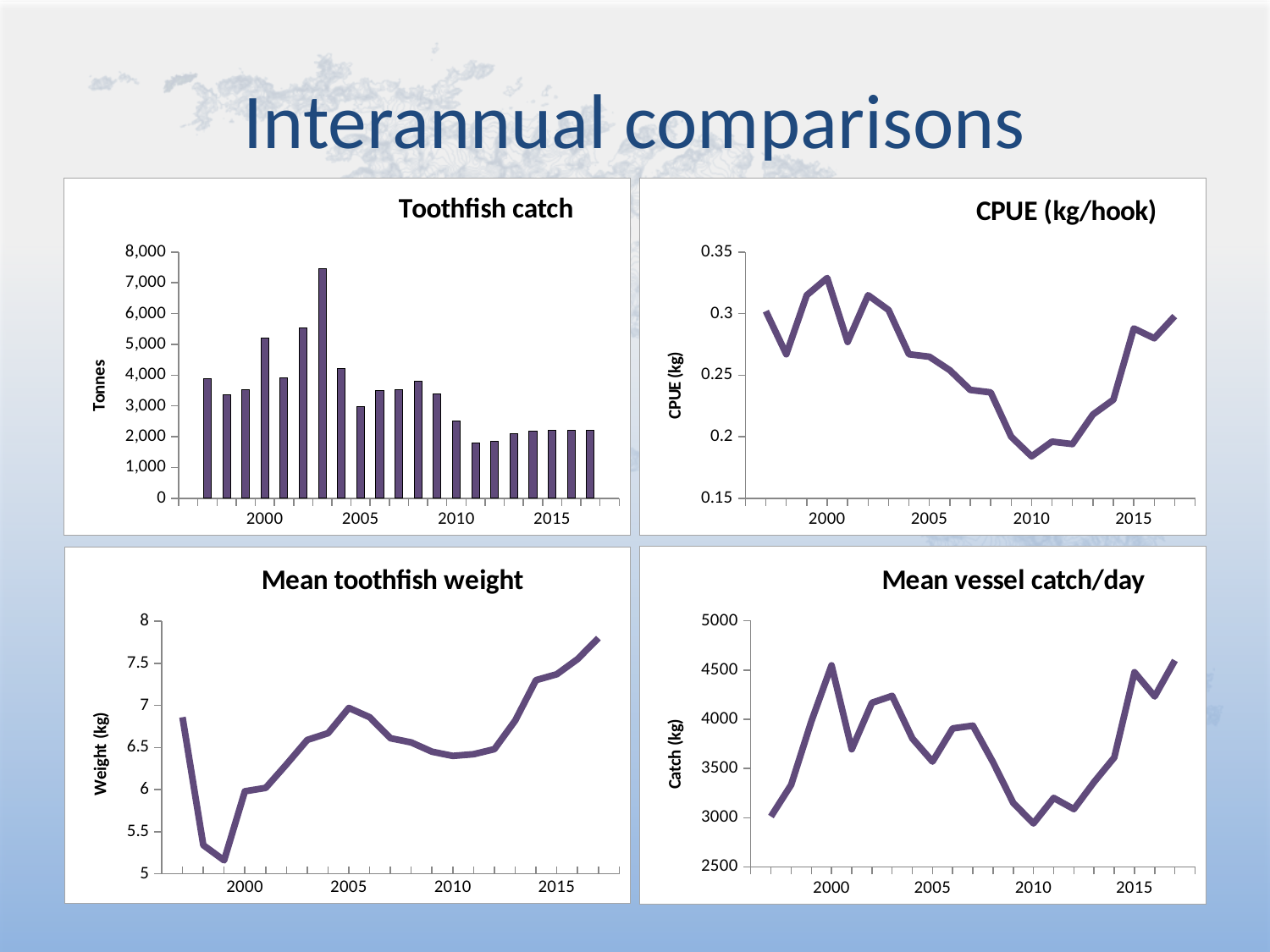
What kind of chart is the "Toothfish catch" chart? bar chart In the "Toothfish catch" chart, is the tallest bar greater or less than 7,000 tonnes? greater What kind of chart is the "CPUE (kg/hook)" chart? line chart In the "CPUE (kg/hook)" chart, is the value for 2000 greater or less than 0.3? greater In the "CPUE (kg/hook)" chart, does the value rise or fall between 2005 and 2010? fall What is the y-axis label of the "Toothfish catch" chart? Tonnes In the "Mean vessel catch/day" chart, is the value for 2010 greater or less than 3500? less In the "Mean toothfish weight" chart, does the value rise or fall between 2010 and 2017? rise In the "Toothfish catch" chart, which year has the larger catch, 2000 or 2010? 2000